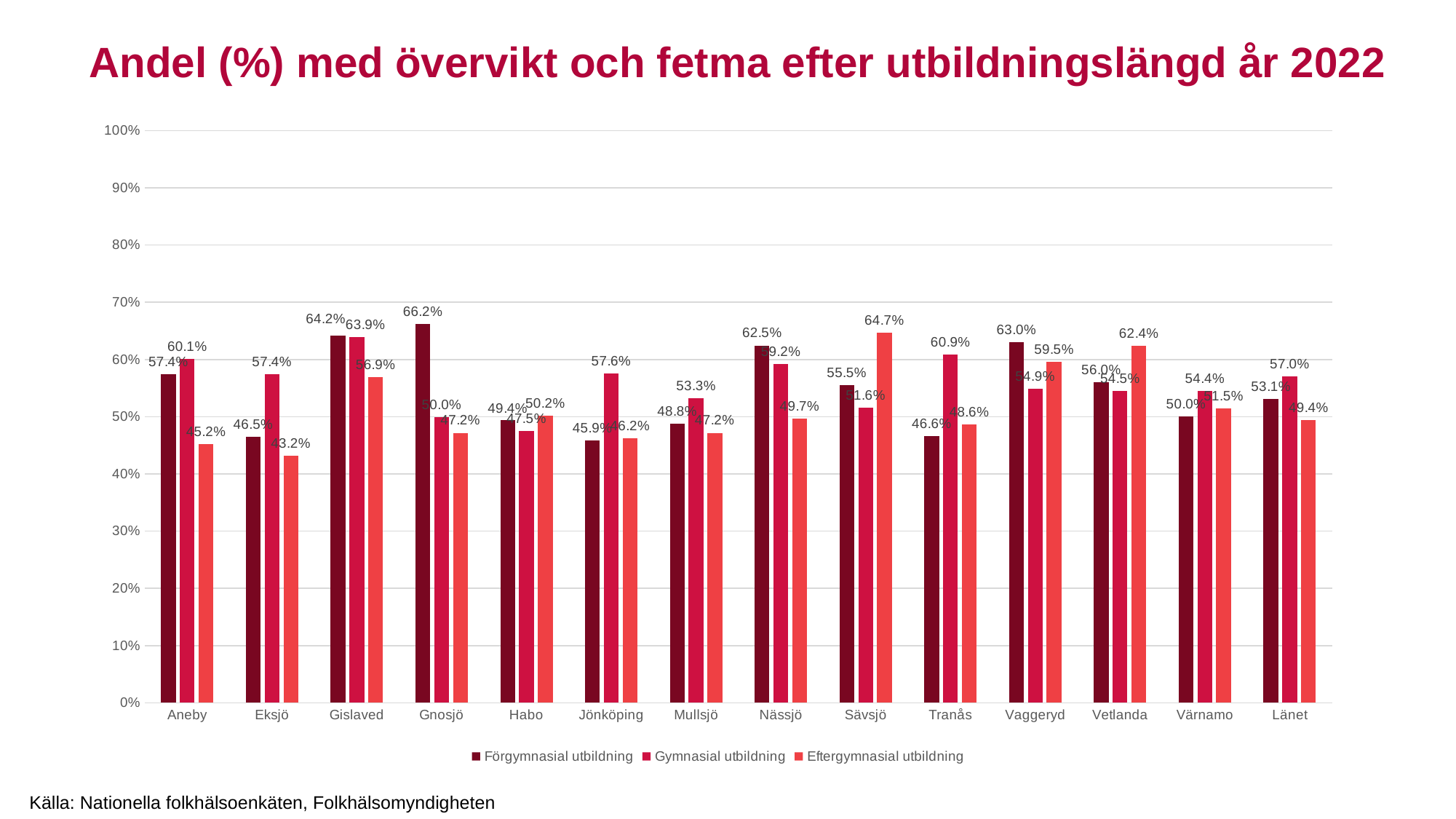
Which is larger for Tranås: the Gymnasial utbildning value or the Förgymnasial utbildning value? Gymnasial utbildning What kind of chart is shown on the slide? Bar chart What is the value for Sävsjö in the Eftergymnasial utbildning series? 64.7% Which category has the lowest value in the Eftergymnasial utbildning series? Eksjö What is the value for Gnosjö in the Förgymnasial utbildning series? 66.2% What is the difference between the Förgymnasial utbildning and Eftergymnasial utbildning values for Gnosjö? 19.0 percentage points What is the title of the chart? Andel (%) med övervikt och fetma efter utbildningslängd år 2022 How many categories are shown on the x axis? 14 What is the value for Länet in the Gymnasial utbildning series? 57.0% Is the Eftergymnasial utbildning value for Vetlanda greater or less than 60%? greater Which category has the highest value in the Förgymnasial utbildning series? Gnosjö How many series does the legend list? 3